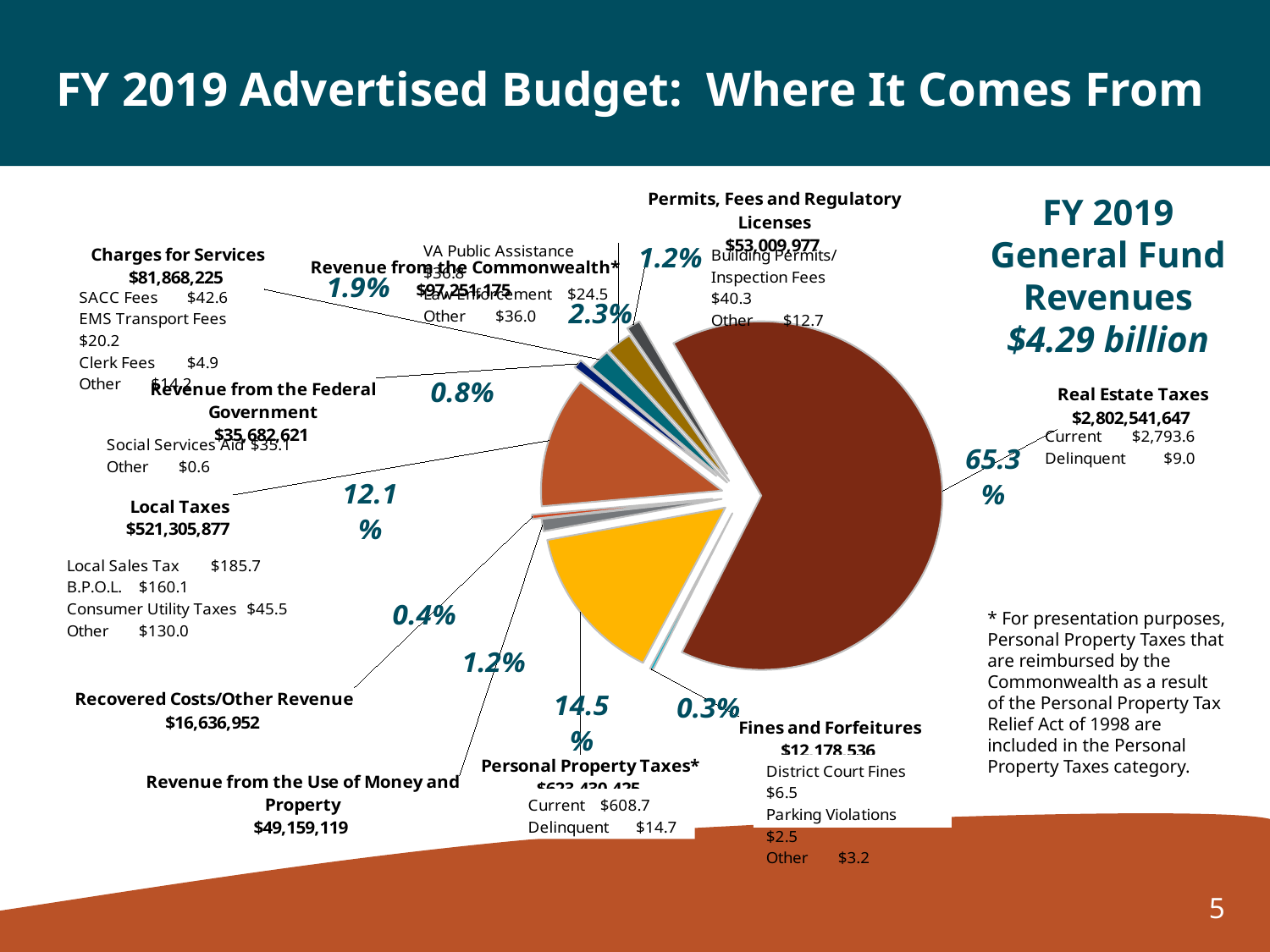
What kind of chart is shown on the slide? pie chart What is the total value of FY 2019 General Fund Revenues shown on the slide? $4.29 billion What is the dollar amount shown for Recovered Costs/Other Revenue? $16,636,952 What is the dollar amount shown for Local Taxes? $521,305,877 Which revenue category has the smallest share of the pie? Fines and Forfeitures What share of the pie do Personal Property Taxes represent? 14.5% What is the dollar amount shown for Real Estate Taxes? $2,802,541,647 Which is larger: Local Taxes or Revenue from the Commonwealth? Local Taxes What is the dollar amount shown for Charges for Services? $81,868,225 How many revenue categories are shown as slices in the pie chart? 10 Which revenue category is the largest slice of the pie? Real Estate Taxes What share of the pie do Real Estate Taxes represent? 65.3%